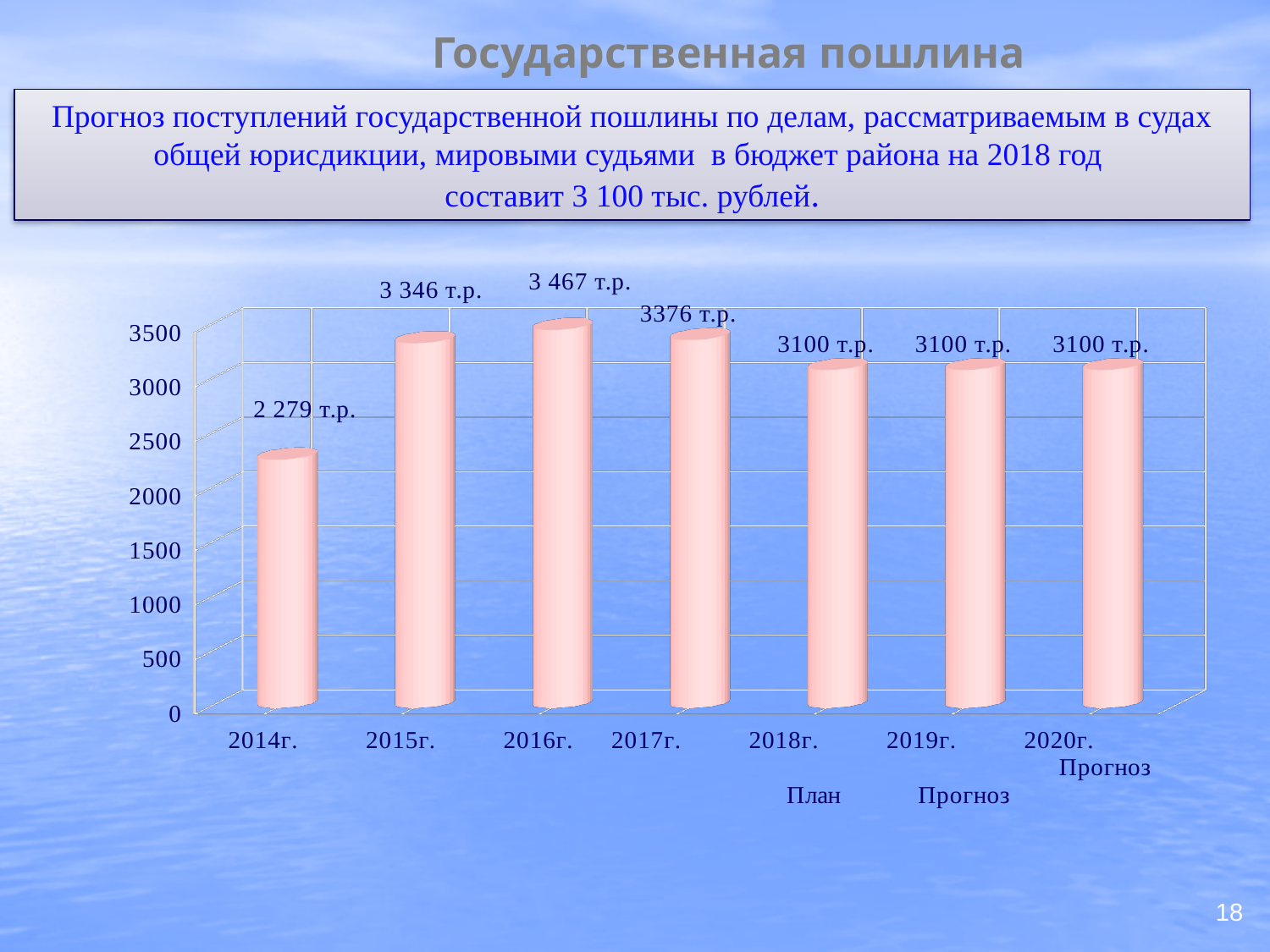
What is the difference between the values for 2016г. and 2015г.? 121 т.р. What value is shown for 2014г.? 2 279 т.р. What is the difference between the values for 2015г. and 2014г.? 1 067 т.р. What value is shown for 2016г.? 3 467 т.р. Is the value for 2014г. greater or less than 2500? less What value is shown for 2017г.? 3376 т.р. Which year has the highest value on the chart? 2016г. How many years are shown on the x axis of the chart? 7 What value is shown for 2018г. (План)? 3100 т.р. Which is larger, the value for 2017г. or the value for 2018г.? 2017г. What kind of chart is shown on the slide? bar chart Which year has the lowest value on the chart? 2014г.